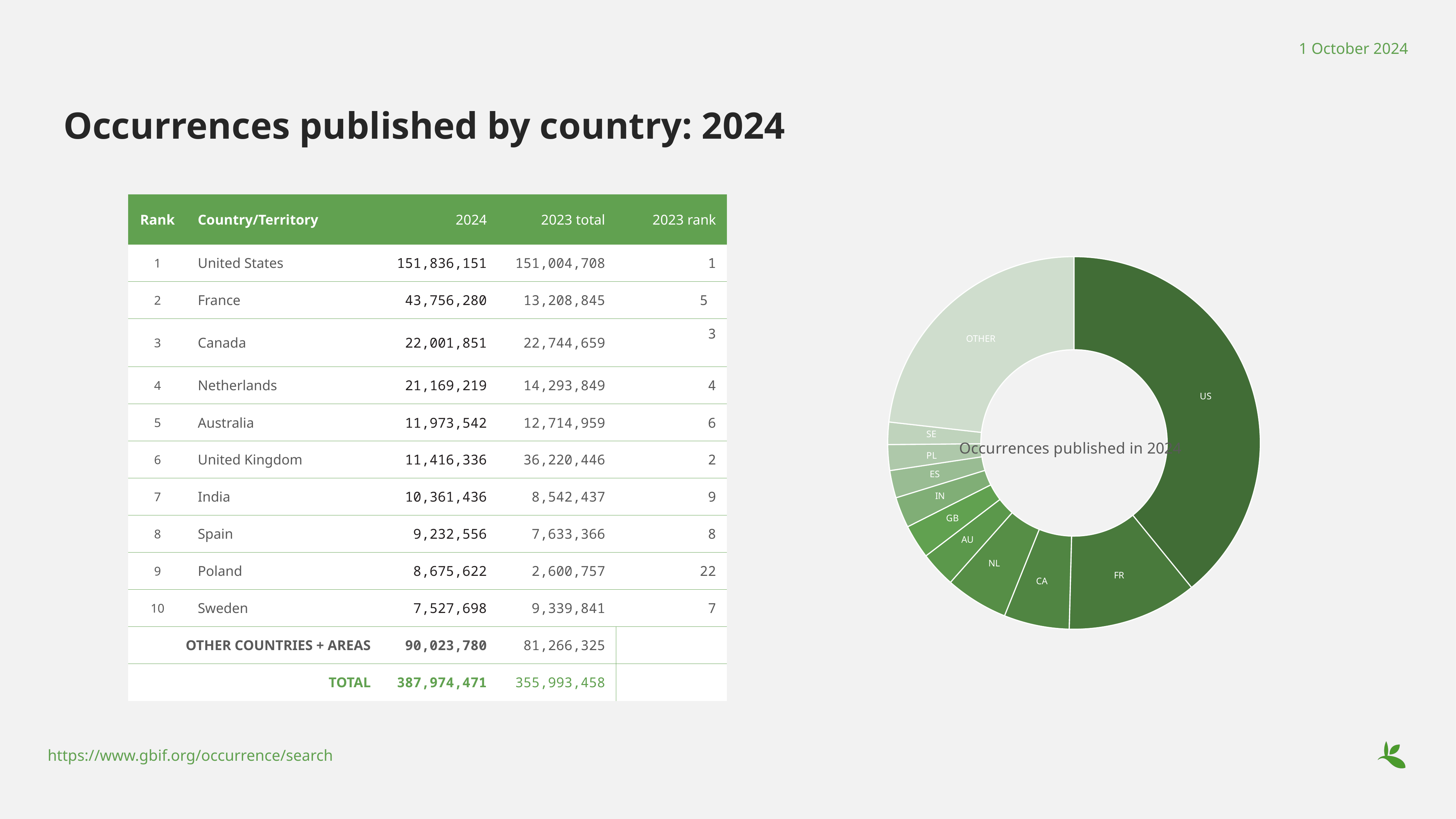
According to the slide, how many occurrences does the FR slice of the donut chart represent for 2024? 43,756,280 What is the difference between the 2024 values for the US and FR slices shown on the slide? 108,079,871 Which country slice (excluding OTHER) is the smallest in the donut chart? SE In the donut chart, which slice is larger, FR or CA? FR How many slices does the donut chart have? 11 What is the title printed in the centre of the donut chart? Occurrences published in 2024 Which slice of the donut chart is the largest? US According to the slide, how many occurrences does the US slice of the donut chart represent for 2024? 151,836,151 Which slice of the donut chart is drawn in the lightest shade of green? OTHER What kind of chart is shown on the right of the slide? donut chart According to the slide, how many occurrences does the OTHER slice of the donut chart represent for 2024? 90,023,780 In the donut chart, which slice is larger, OTHER or FR? OTHER